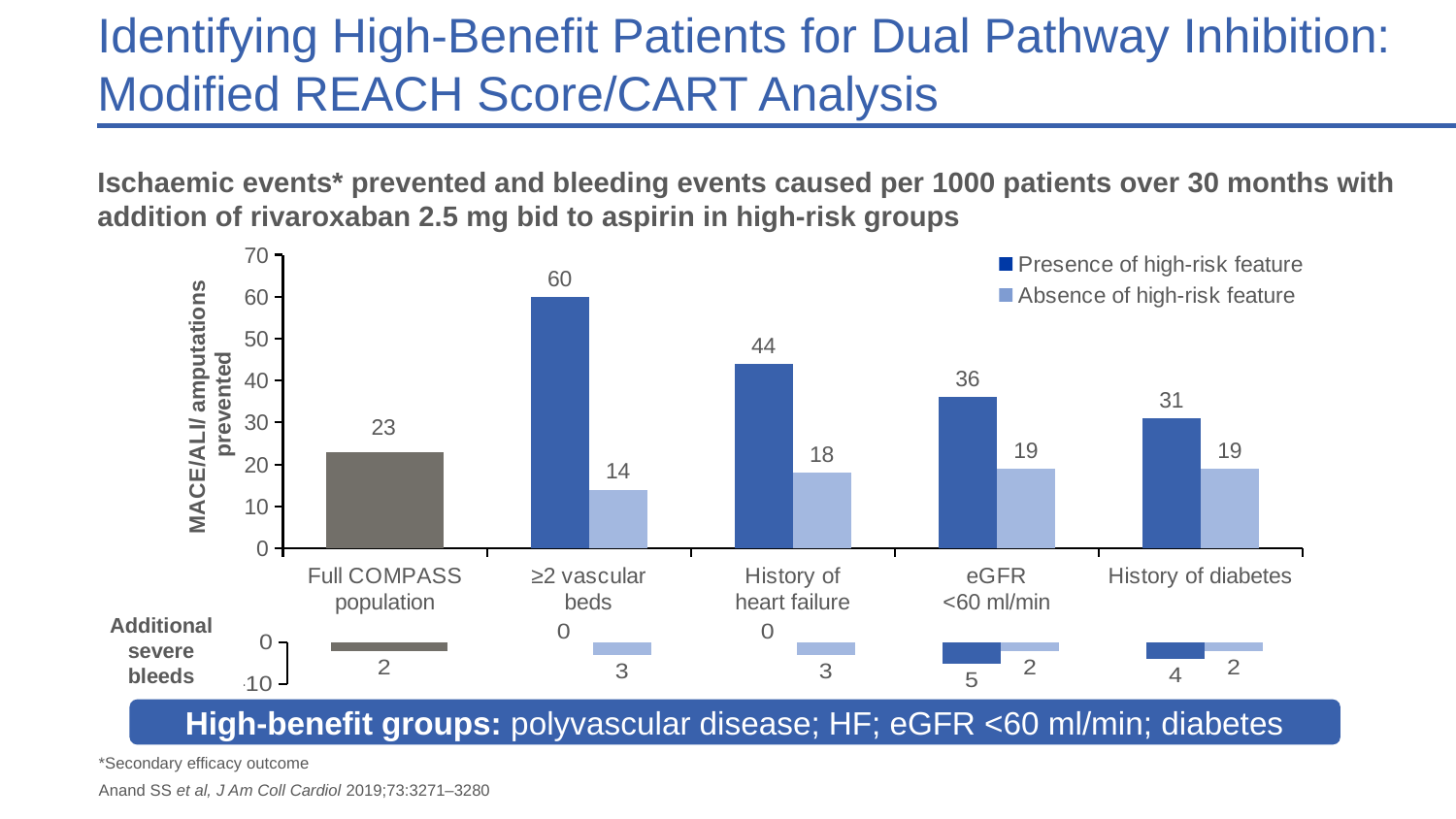
In the upper chart (MACE/ALI/amputations prevented), what is the value for the presence of high-risk feature in the ≥2 vascular beds group? 60 In the upper chart (MACE/ALI/amputations prevented), which group has the highest value for presence of high-risk feature? ≥2 vascular beds In the upper chart (MACE/ALI/amputations prevented), what is the value for the absence of high-risk feature in the History of heart failure group? 18 What kind of chart is the upper chart (MACE/ALI/amputations prevented)? bar chart How many series does the legend of the upper chart list? 2 In the upper chart (MACE/ALI/amputations prevented), which group has the lowest value for absence of high-risk feature? ≥2 vascular beds In the upper chart (MACE/ALI/amputations prevented), what is the value for the Full COMPASS population? 23 In the lower chart (Additional severe bleeds), what is the value for presence of high-risk feature in the eGFR <60 ml/min group? 5 In the upper chart (MACE/ALI/amputations prevented), is the presence value for History of heart failure larger or smaller than the presence value for History of diabetes? larger In the lower chart (Additional severe bleeds), what is the value for presence of high-risk feature in the History of heart failure group? 0 How many categories are shown on the x axis of the upper chart (MACE/ALI/amputations prevented)? 5 In the upper chart (MACE/ALI/amputations prevented), what is the difference between the presence and absence values for the eGFR <60 ml/min group? 17